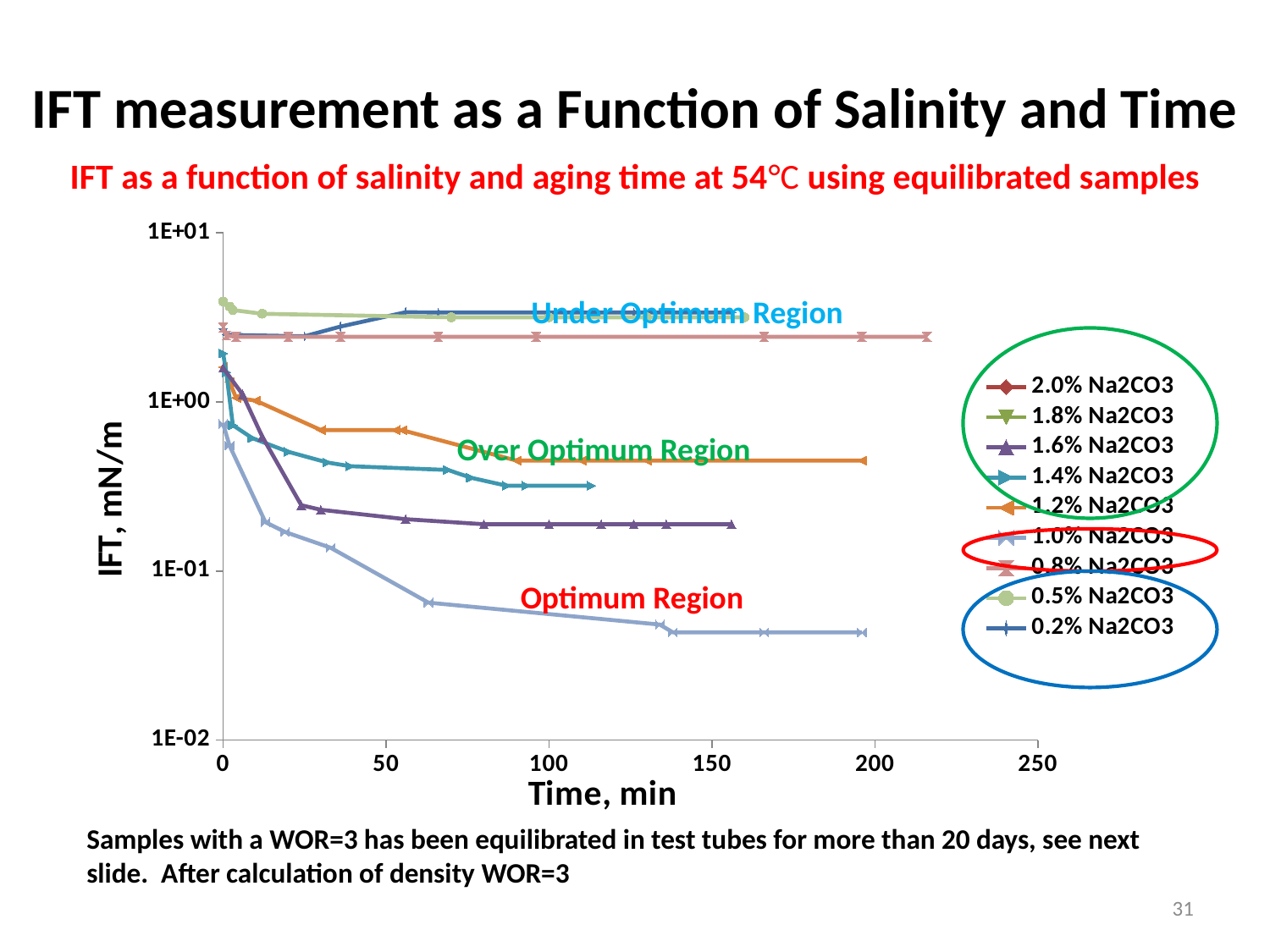
How many series does the legend list? 9 At around 100 min, which series has the higher IFT: 1.0% Na2CO3 or 1.6% Na2CO3? 1.6% Na2CO3 Does the IFT for 1.0% Na2CO3 rise or fall as time increases? fall What kind of chart is shown on the slide? line chart Is the IFT value for 0.8% Na2CO3 greater or less than 1E+00? greater Which series has the lowest IFT at around 200 min? 1.0% Na2CO3 Is the IFT value for 1.6% Na2CO3 at around 150 min greater or less than 1E+00? less What is the title of the y axis? IFT, mN/m Is the IFT value for 1.2% Na2CO3 at around 200 min greater or less than 1E+00? less What is the title of the x axis? Time, min Does the IFT for 1.6% Na2CO3 rise or fall as time increases? fall